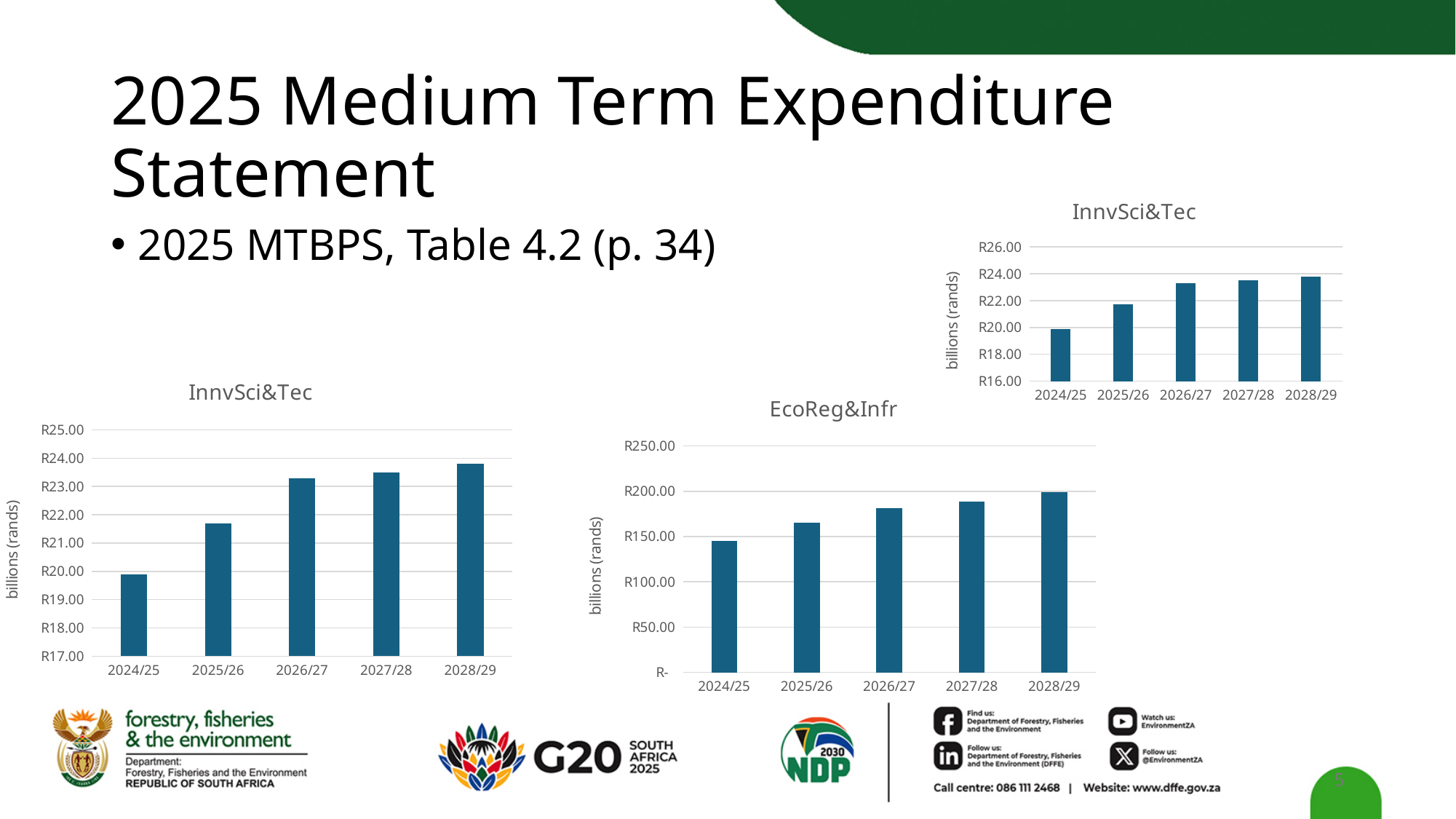
How many charts are shown on the slide? 3 In the InnvSci&Tec chart at the top right of the slide, what is the label on the vertical axis? billions (rands) In the InnvSci&Tec chart at the bottom left of the slide, is the value for 2025/26 greater or less than R22.00? less What type of chart is the EcoReg&Infr chart? bar chart In the EcoReg&Infr chart, which year has the lowest value? 2024/25 In the EcoReg&Infr chart, which year has the highest value? 2028/29 In the InnvSci&Tec chart at the bottom left of the slide, which year has the lowest value? 2024/25 In the EcoReg&Infr chart, is the value for 2024/25 greater or less than R150.00? less In the InnvSci&Tec chart at the top right of the slide, is the value for 2026/27 greater or less than R22.00? greater In the EcoReg&Infr chart, do the values rise or fall from 2024/25 to 2028/29? rise In the EcoReg&Infr chart, how many categories are shown on the x axis? 5